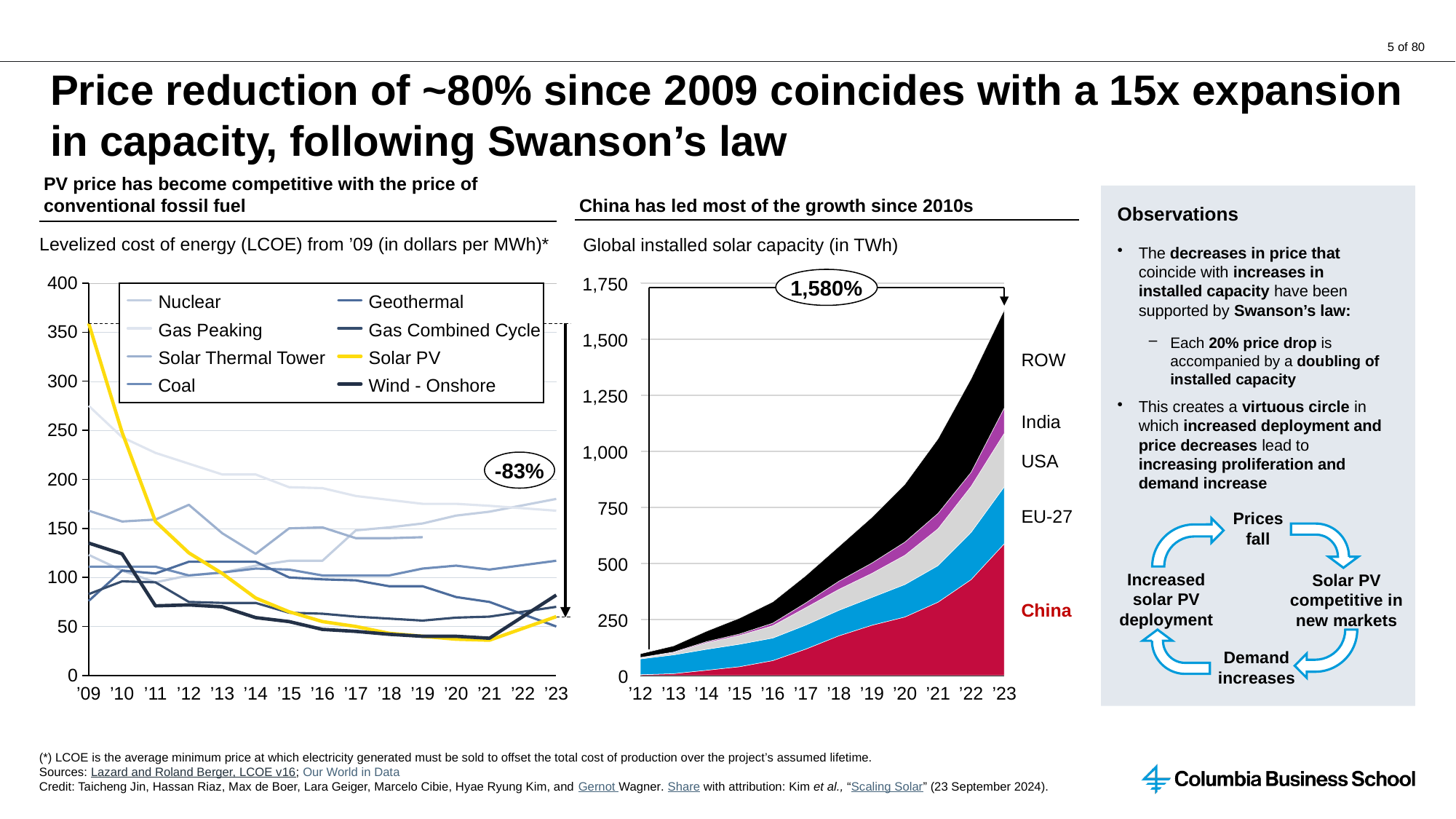
In the right 'Global installed solar capacity' chart, which region contributes the largest share in '23? China What kind of chart is the right chart, 'Global installed solar capacity (in TWh)'? Stacked area chart How many years are shown on the x axis of the left LCOE chart? 15 In the right 'Global installed solar capacity' chart, does total capacity rise or fall from '12 to '23? Rise In the left LCOE chart, does the Solar PV line rise or fall from '09 to '23? Fall In the left LCOE chart, which series has the highest value in '09? Solar PV In the right 'Global installed solar capacity' chart, is the total capacity in '23 greater or less than 1,500? greater What kind of chart is the left chart, 'Levelized cost of energy (LCOE) from '09 (in dollars per MWh)'? Line chart How many years are shown on the x axis of the right 'Global installed solar capacity' chart? 12 In the left LCOE chart, is the Solar PV value in '09 greater or less than 300? greater What percentage change is annotated on the left LCOE chart? -83% How many series does the legend of the left LCOE chart list? 8